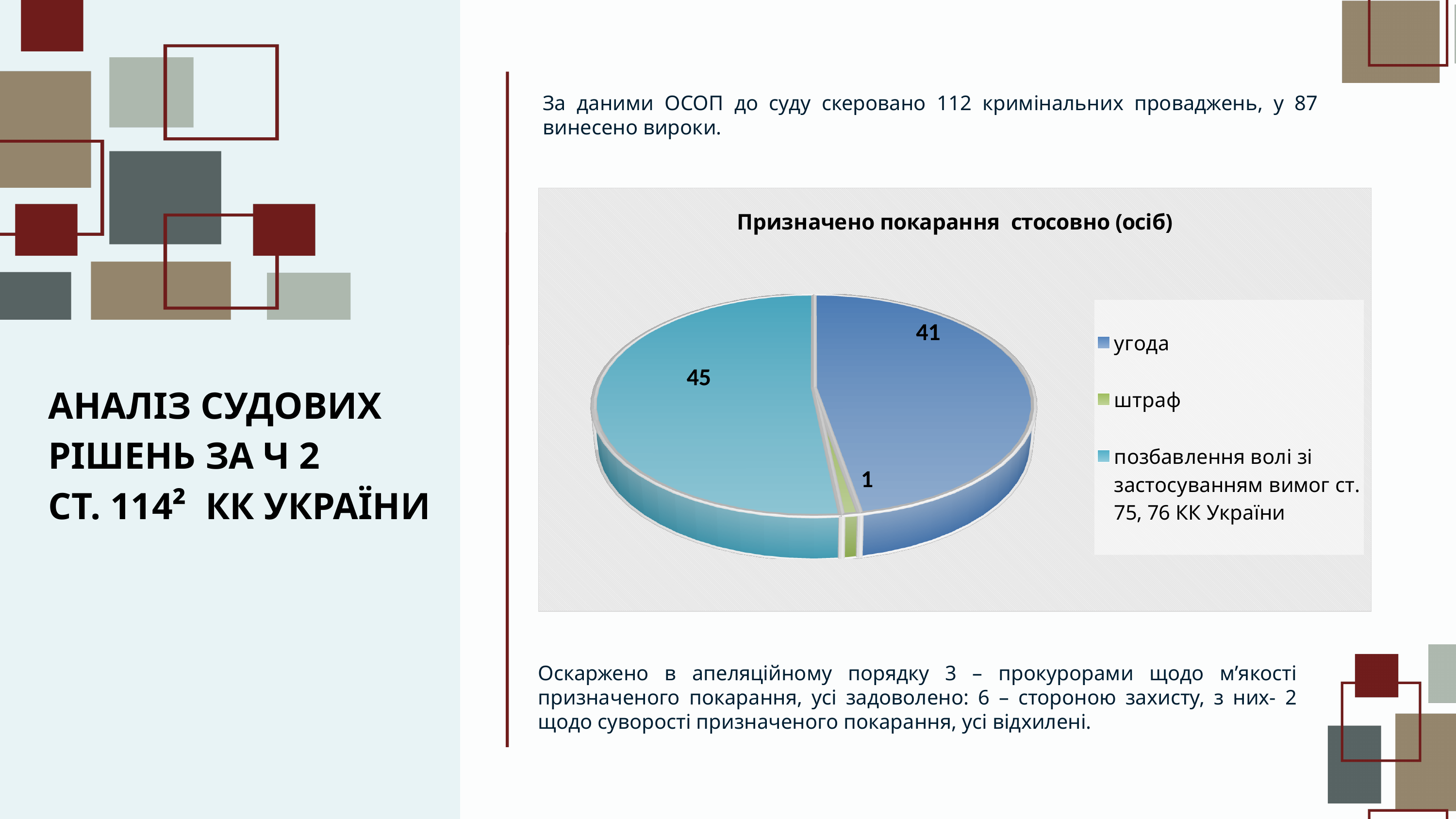
What type of chart is shown on the slide? pie chart How many slices does the pie chart have? 3 How many entries does the chart legend list? 3 Which category has the smallest slice of the pie? штраф What is the total of all slices in the pie chart? 87 What is the value for "угода"? 41 What is the value for "позбавлення волі зі застосуванням вимог ст. 75, 76 КК України"? 45 What is the value for "штраф"? 1 Which is larger, the value for "угода" or the value for "штраф"? угода What is the title of the chart? Призначено покарання стосовно (осіб) What is the difference between the values for "позбавлення волі зі застосуванням вимог ст. 75, 76 КК України" and "угода"? 4 Which category has the largest slice of the pie? позбавлення волі зі застосуванням вимог ст. 75, 76 КК України